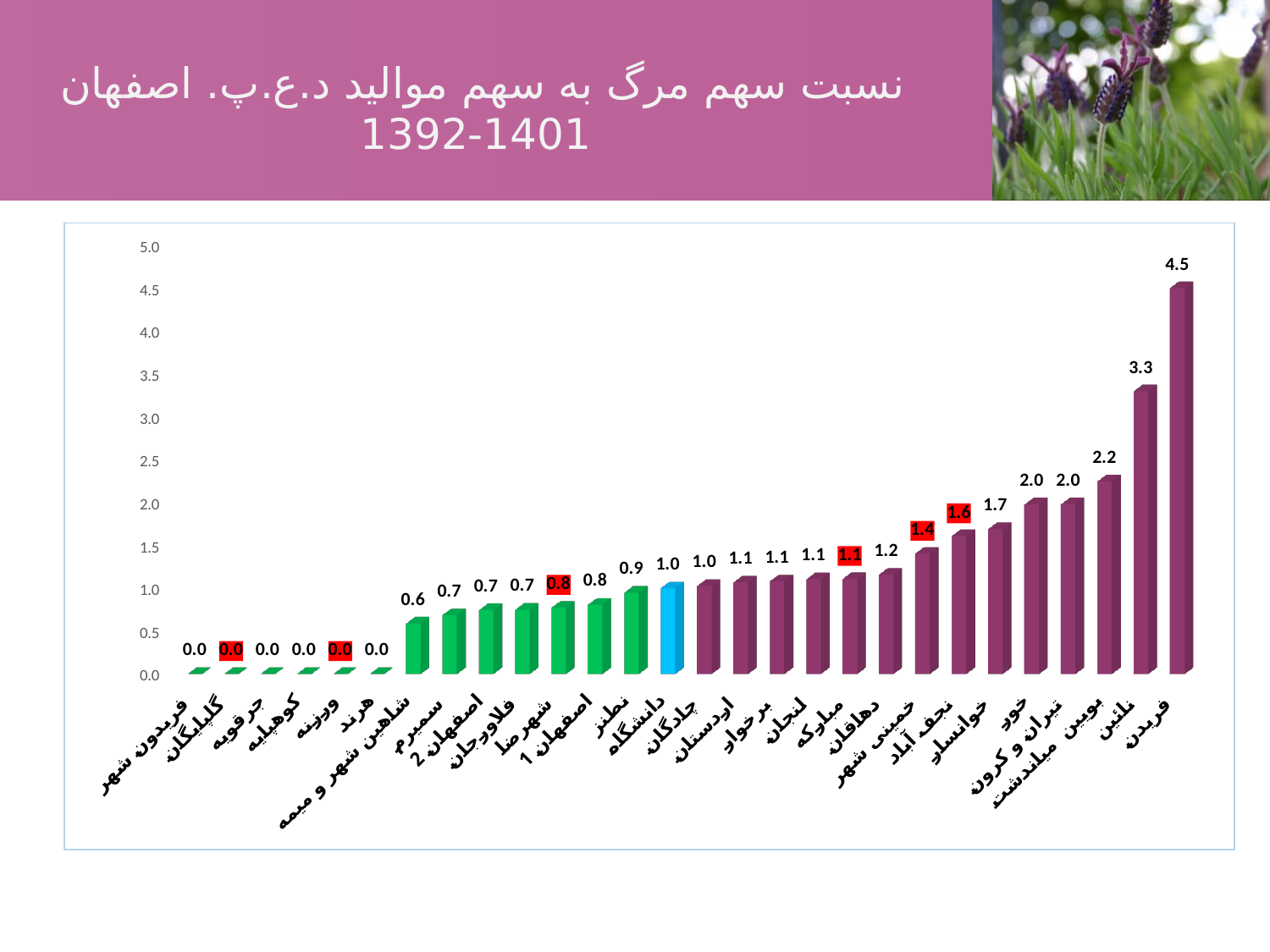
What is the value for فریدن? 4.5 What is the value for نجف آباد? 1.6 Which is larger, the value for خوانسار or the value for دهاقان? خوانسار What is the value for دانشگاه (the blue bar)? 1.0 How many categories are shown on the x axis? 28 Which category has the highest value? فریدن Is the value for بوئین میاندشت greater or less than 2.0? greater What is the value for نائین? 3.3 What is the value for خمینی شهر? 1.4 What kind of chart is shown on the slide? bar chart What is the difference between the values for فریدن and نائین? 1.2 Do the values generally rise or fall from left to right along the x axis? rise